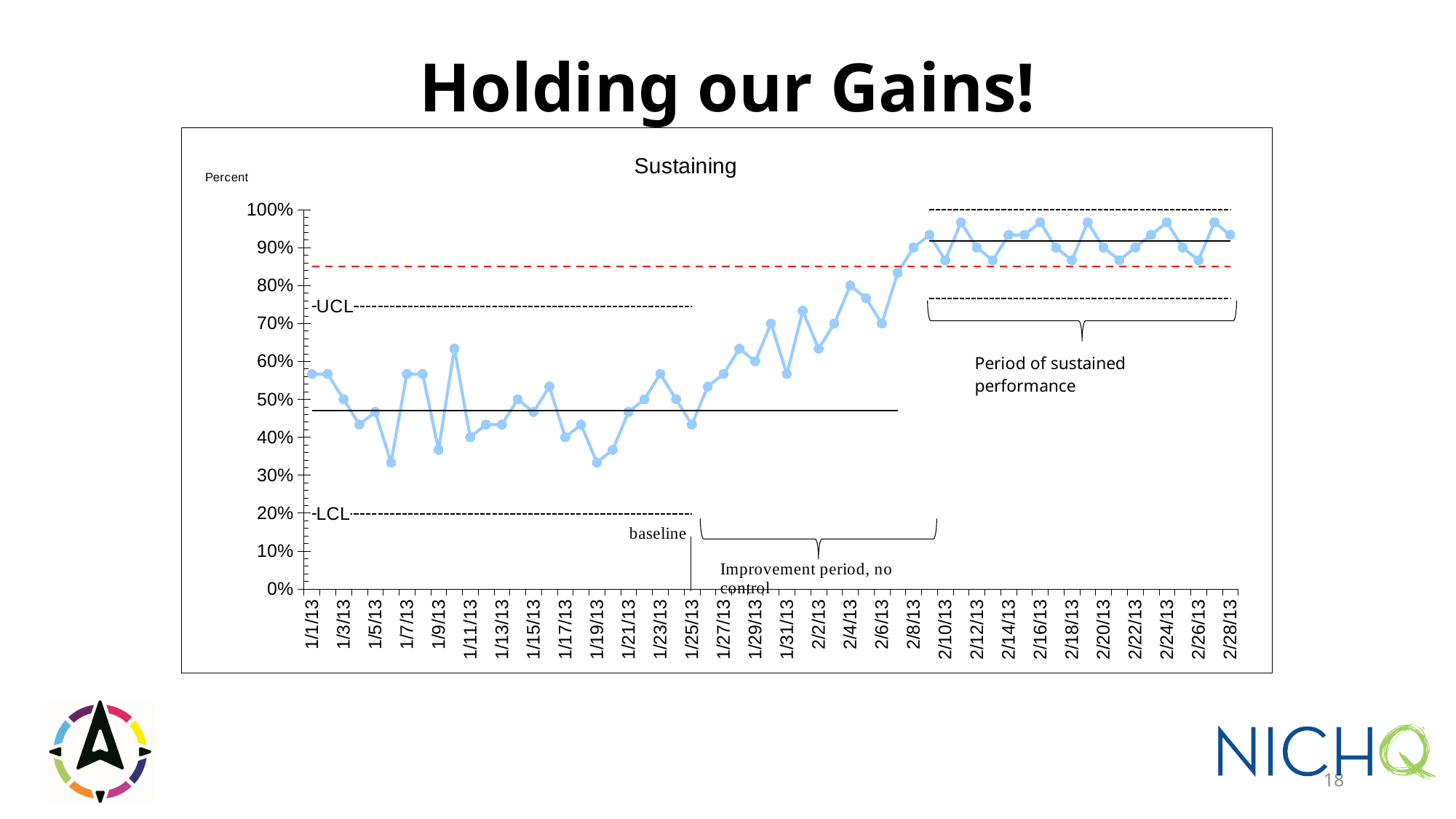
What is the title of the chart? Sustaining Overall, do the values rise or fall from 1/1/13 to 2/28/13? rise Is the value for 2/28/13 greater or less than 90%? greater Is the value for 2/16/13 greater or less than 90%? greater Is the value for 1/19/13 greater or less than 40%? less What kind of chart is shown on the slide? line chart What label is shown on the vertical axis of the chart? Percent Do the values generally rise or fall between 1/25/13 and 2/8/13? rise Which date has the larger value, 1/1/13 or 2/28/13? 2/28/13 Which date has the larger value, 1/19/13 or 1/1/13? 1/1/13